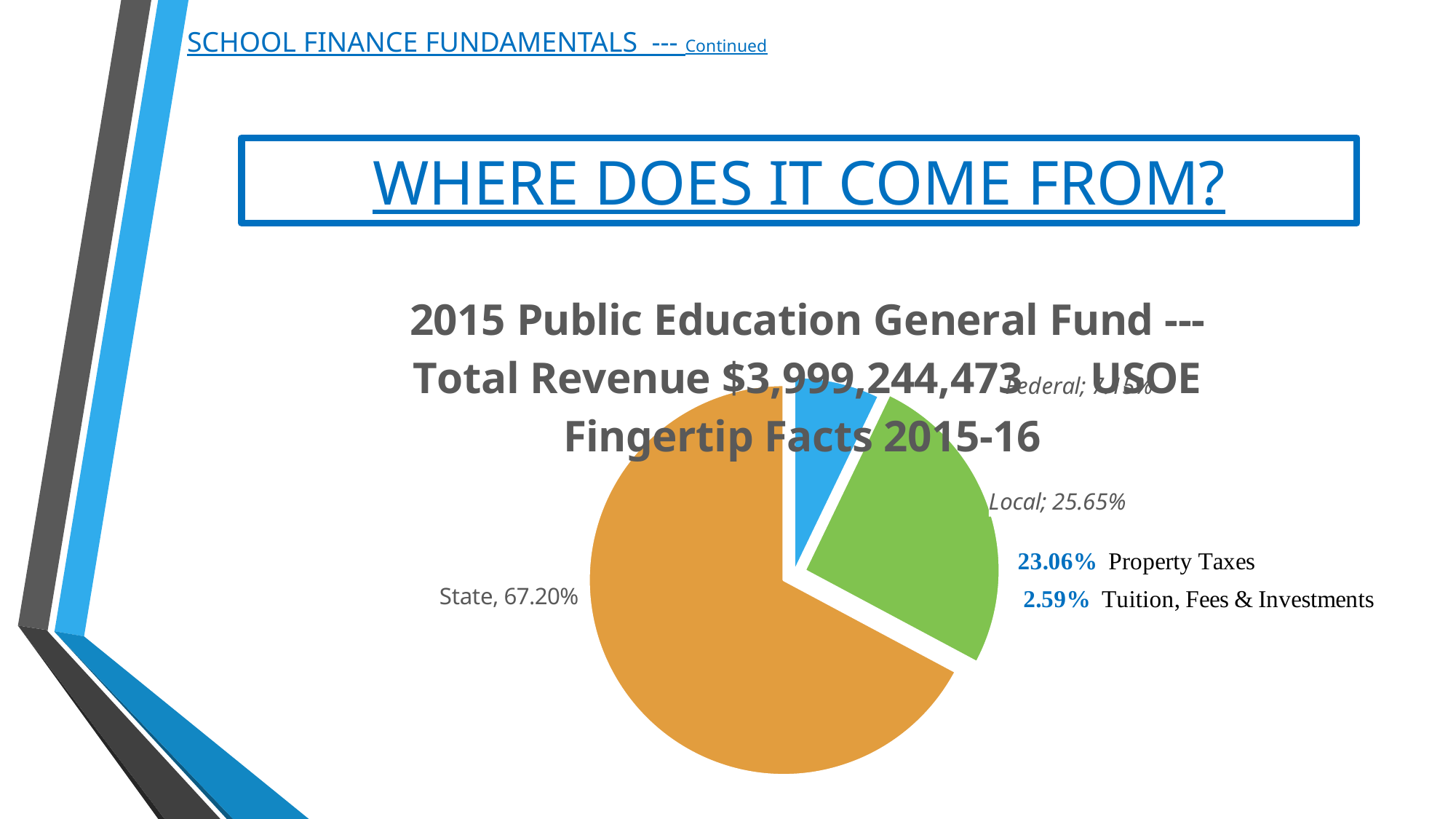
Which is larger, the State share or the Local share? State What is the difference between the State share and the Local share? 41.55% Which revenue source has the largest slice of the pie? State What percentage of the 2015 Public Education General Fund revenue comes from Local sources? 25.65% Which revenue source has the smallest slice of the pie? Federal Is the State share greater or less than 50%? greater According to the annotation next to the chart, what percentage comes from Property Taxes? 23.06% How many slices does the pie chart have? 3 What kind of chart is shown on the slide? pie chart What percentage of the 2015 Public Education General Fund revenue comes from State sources? 67.20% What total revenue figure is given in the chart title? $3,999,244,473 What colour is the State slice of the pie? orange